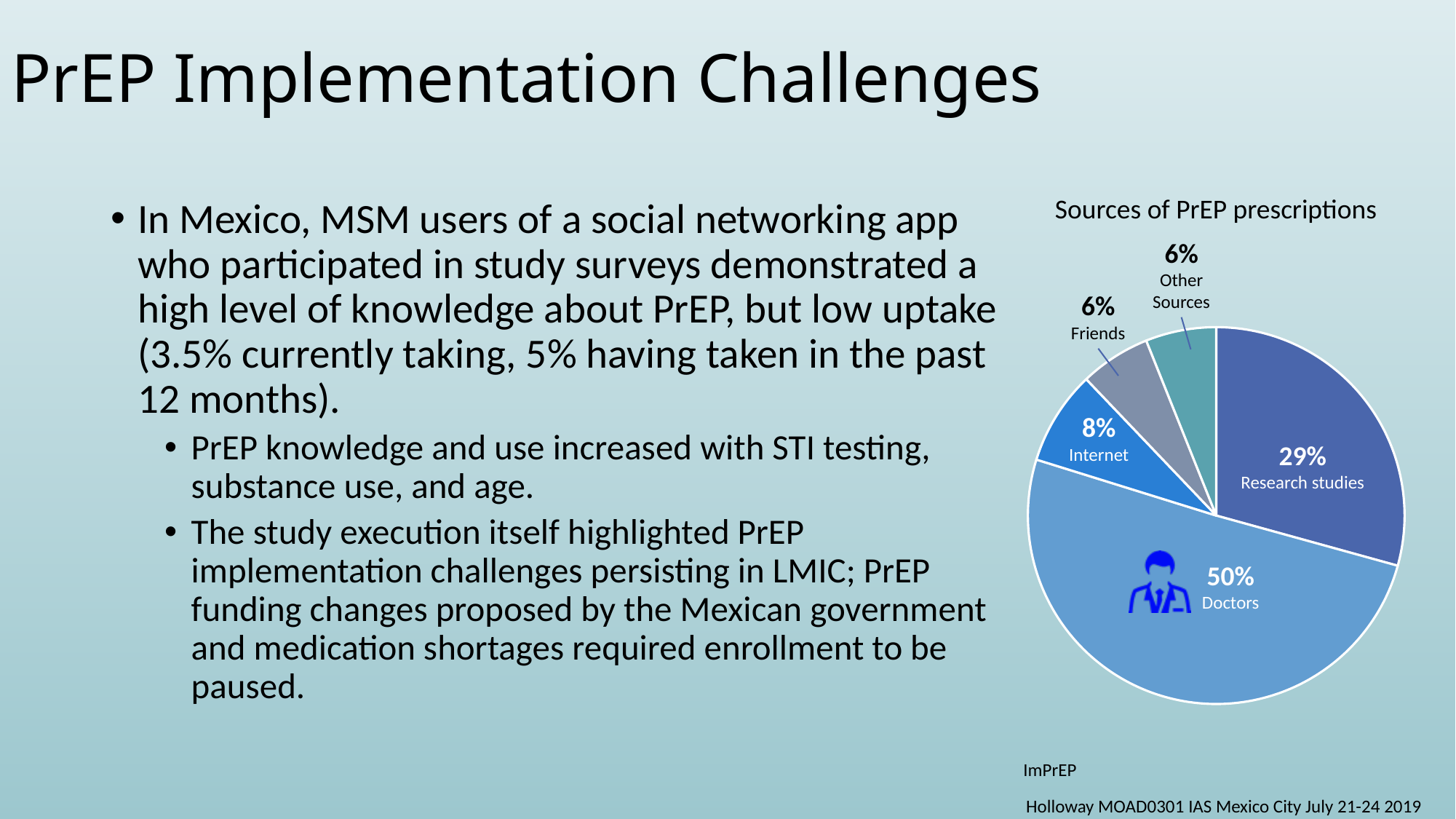
What type of chart is shown on the slide? pie chart What is the title of the chart? Sources of PrEP prescriptions What is the difference in percentage points between the Doctors and Research studies slices? 21 Which is larger, the share for Internet or the share for Friends? Internet How many slices does the pie chart have? 5 What share of PrEP prescriptions came from Doctors? 50% What share of PrEP prescriptions came from Research studies? 29% What share of PrEP prescriptions came from Other Sources? 6% What is the combined share of Doctors and Research studies? 79% What share of PrEP prescriptions came from the Internet? 8% What share of PrEP prescriptions came from Friends? 6% Which source accounts for the largest share of PrEP prescriptions? Doctors